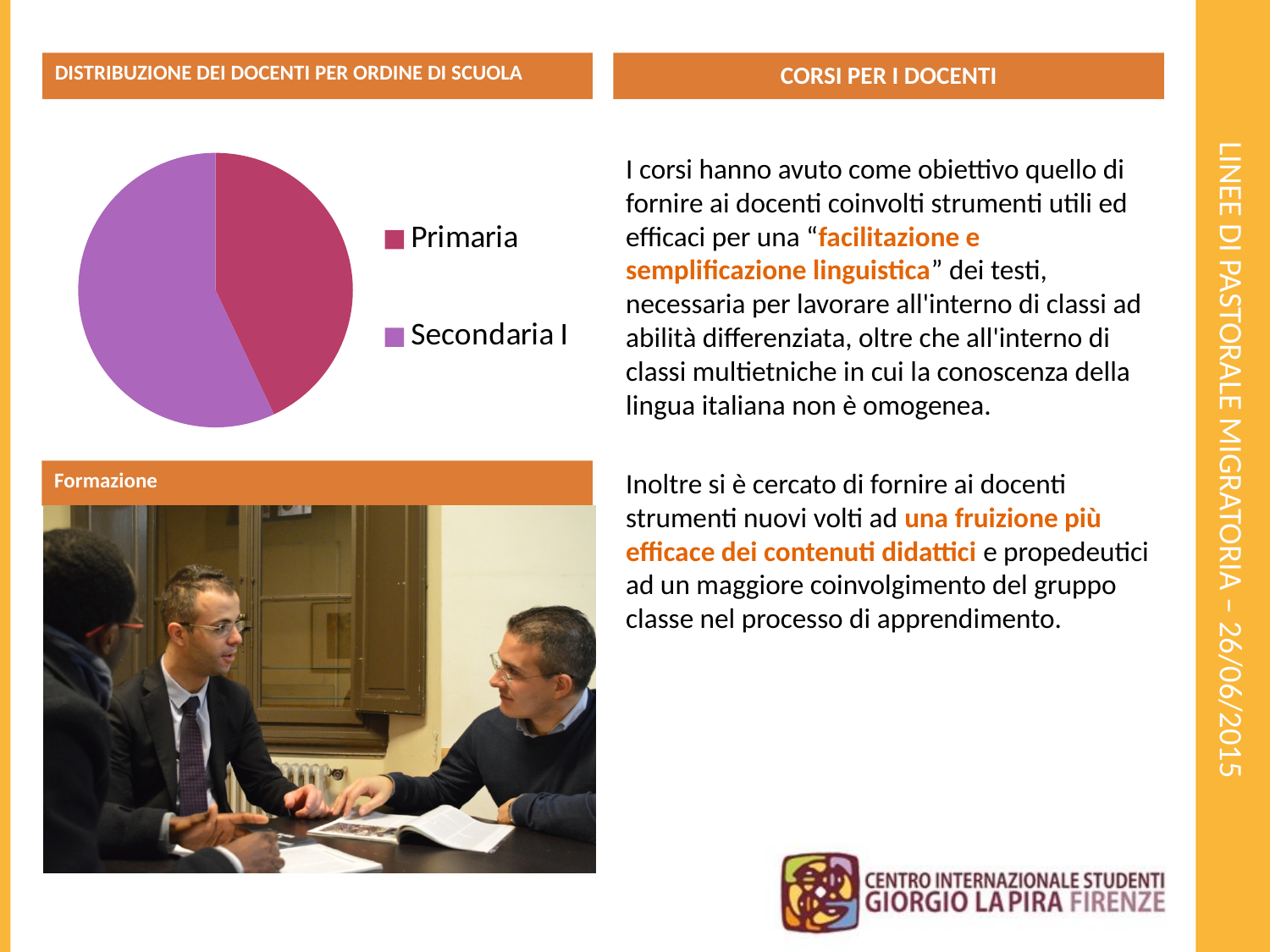
Does the Secondaria I slice cover more or less than half of the pie chart? More What kind of chart is shown under the heading "DISTRIBUZIONE DEI DOCENTI PER ORDINE DI SCUOLA"? Pie chart Which category takes the largest share of the pie chart? Secondaria I In the pie chart, which slice is larger: Primaria or Secondaria I? Secondaria I Which category takes the smallest share of the pie chart? Primaria How many slices does the pie chart have? 2 Which colour represents Primaria in the pie chart? Magenta (dark pink) What are the two categories listed in the legend of the pie chart? Primaria and Secondaria I How many entries does the legend of the pie chart list? 2